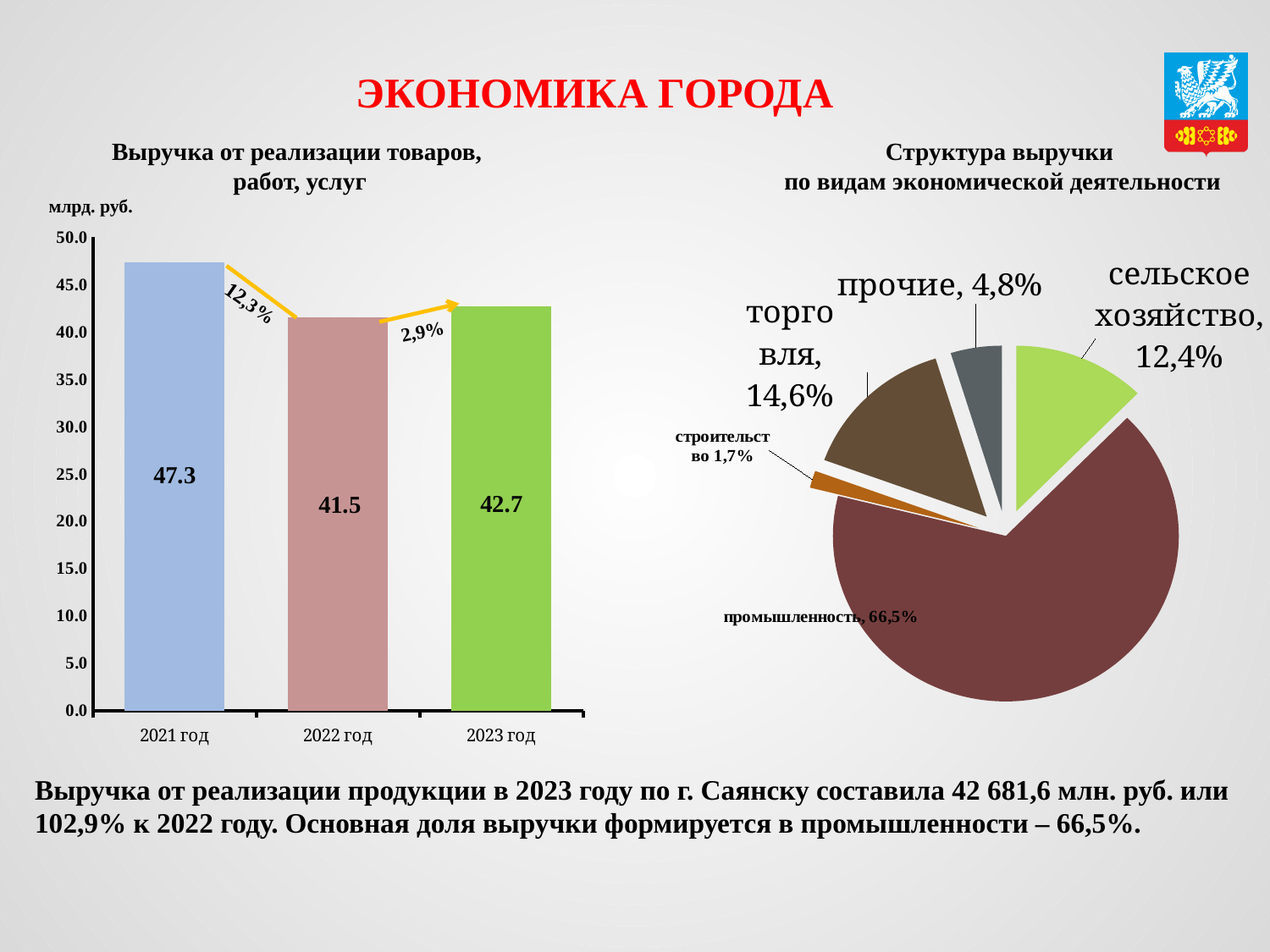
What kind of chart is the left chart 'Выручка от реализации товаров, работ, услуг'? Bar chart In the pie chart 'Структура выручки по видам экономической деятельности', what share does промышленность have? 66,5% In the bar chart 'Выручка от реализации товаров, работ, услуг', what is the value for 2023 год? 42.7 In the bar chart 'Выручка от реализации товаров, работ, услуг', what unit is shown on the vertical axis? млрд. руб. In the bar chart 'Выручка от реализации товаров, работ, услуг', what is the difference between the values for 2021 год and 2022 год? 5.8 In the pie chart 'Структура выручки по видам экономической деятельности', what share does торговля have? 14,6% In the pie chart 'Структура выручки по видам экономической деятельности', which category has the smallest share? строительство In the pie chart 'Структура выручки по видам экономической деятельности', how many slices are there? 5 In the bar chart 'Выручка от реализации товаров, работ, услуг', which year has the highest value? 2021 год In the bar chart 'Выручка от реализации товаров, работ, услуг', how many bars are shown? 3 In the bar chart 'Выручка от реализации товаров, работ, услуг', which year has the lowest value? 2022 год In the bar chart 'Выручка от реализации товаров, работ, услуг', what is the value for 2022 год? 41.5